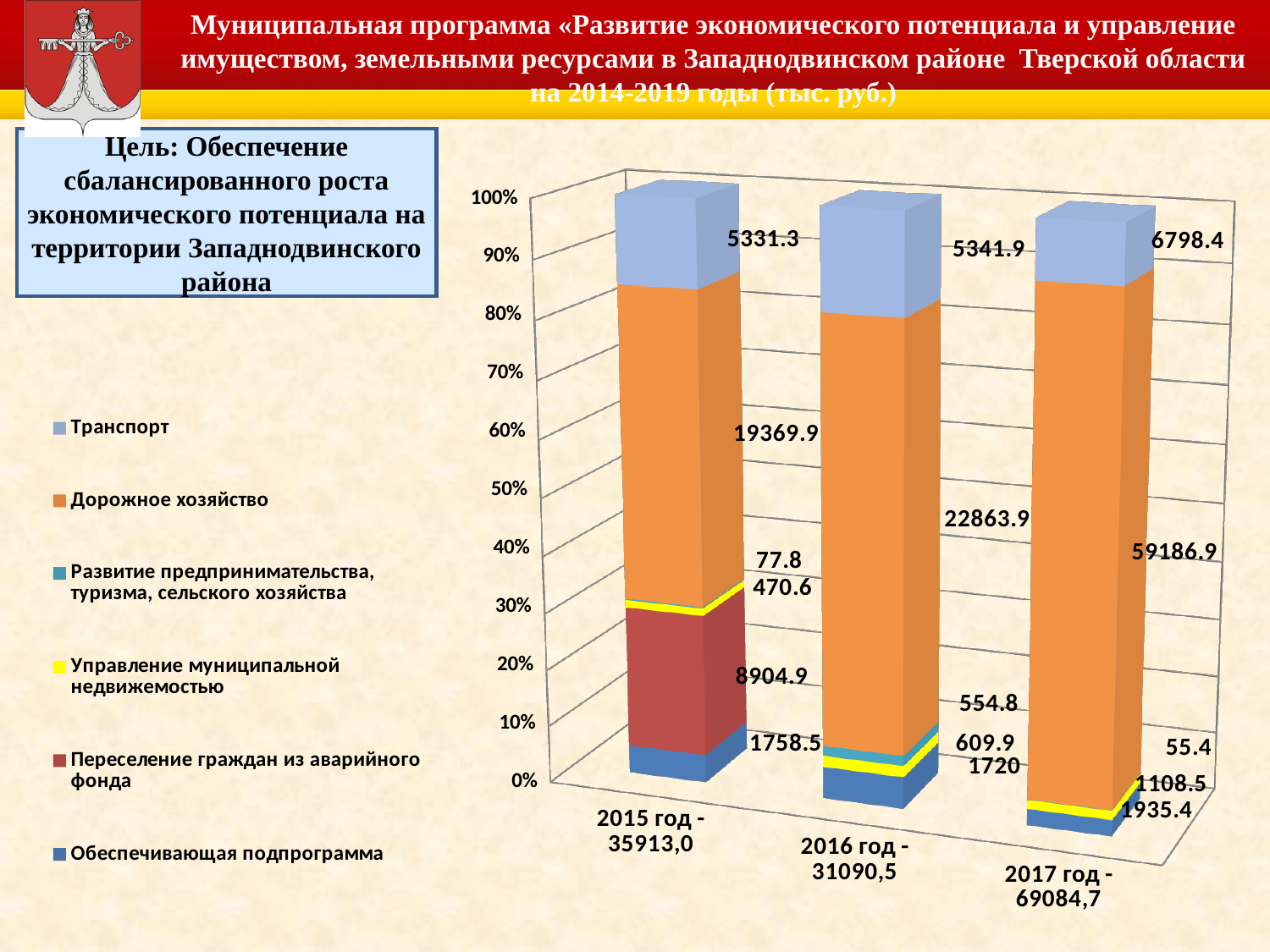
Does the value for Дорожное хозяйство rise or fall from 2015 год to 2017 год? Rise How many years (bars) are shown on the chart? 3 How many series does the legend list? 6 What kind of chart is shown on the slide? Stacked bar chart What is the difference between the Транспорт values for 2017 год and 2015 год? 1467.1 In which year is the value for Развитие предпринимательства, туризма, сельского хозяйства the lowest? 2017 год In which year is the value for Дорожное хозяйство the highest? 2017 год What is the value for Транспорт in 2015 год? 5331.3 What is the value for Переселение граждан из аварийного фонда in 2015 год? 8904.9 Which is larger: Обеспечивающая подпрограмма in 2015 год or in 2016 год? 2015 год What is the value for Дорожное хозяйство in 2017 год? 59186.9 What is the value for Управление муниципальной недвижимостью in 2016 год? 609.9